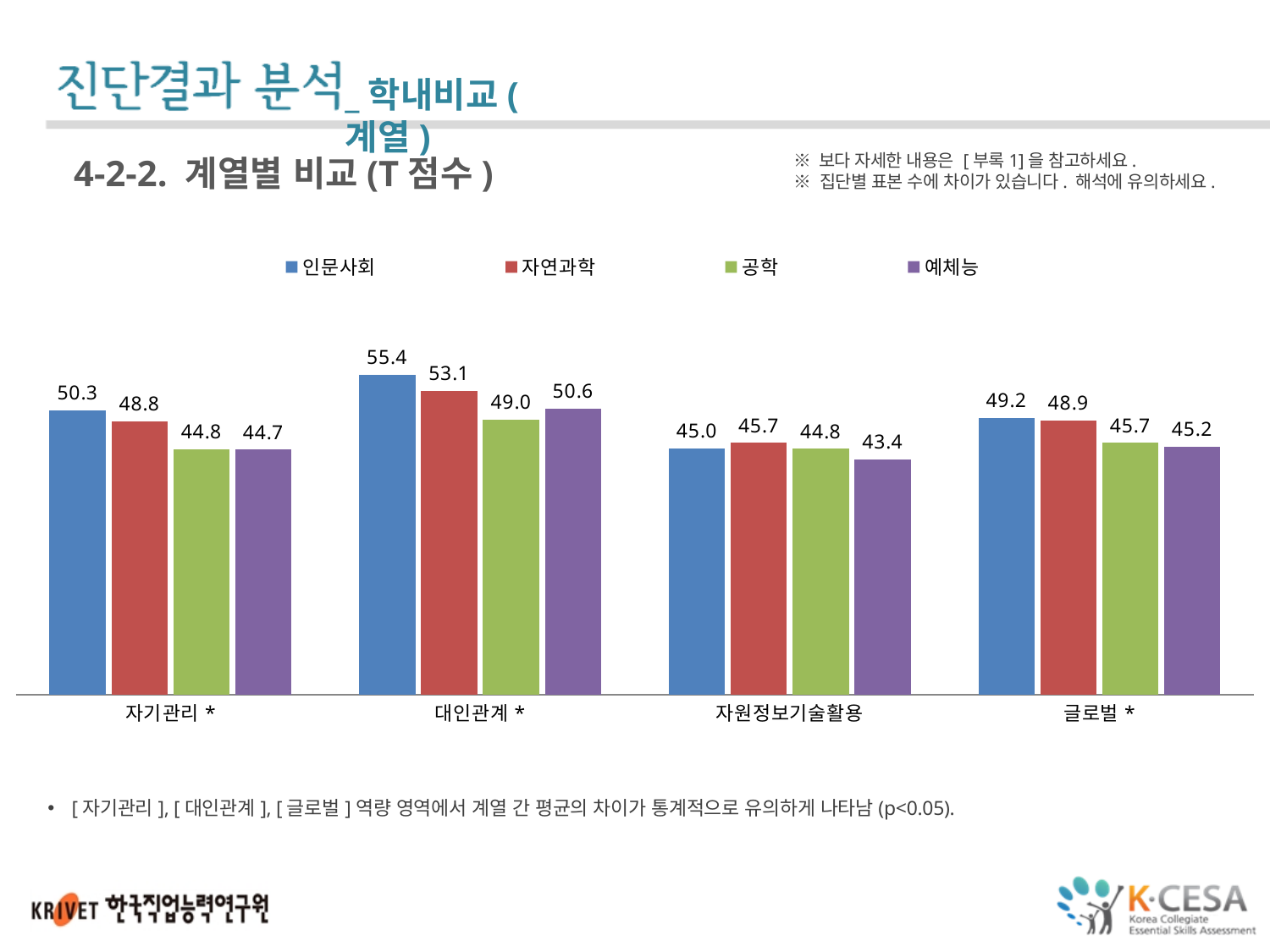
Which series has the highest value in the 대인관계 * category? 인문사회 What is the difference between the 인문사회 and 공학 values in the 대인관계 * category? 6.4 How many categories are shown on the x axis of the chart? 4 Which is larger in the 자원정보기술활용 category: the value for 인문사회 or the value for 자연과학? 자연과학 How many series does the legend list? 4 What kind of chart is shown on the slide? Bar chart What is the value for 예체능 in the 자원정보기술활용 category? 43.4 What is the value for 공학 in the 글로벌 * category? 45.7 What is the value for 자연과학 in the 자기관리 * category? 48.8 Which series has the lowest value in the 자원정보기술활용 category? 예체능 What is the value for 인문사회 in the 대인관계 * category? 55.4 Which colour represents the 공학 series in the chart? Green